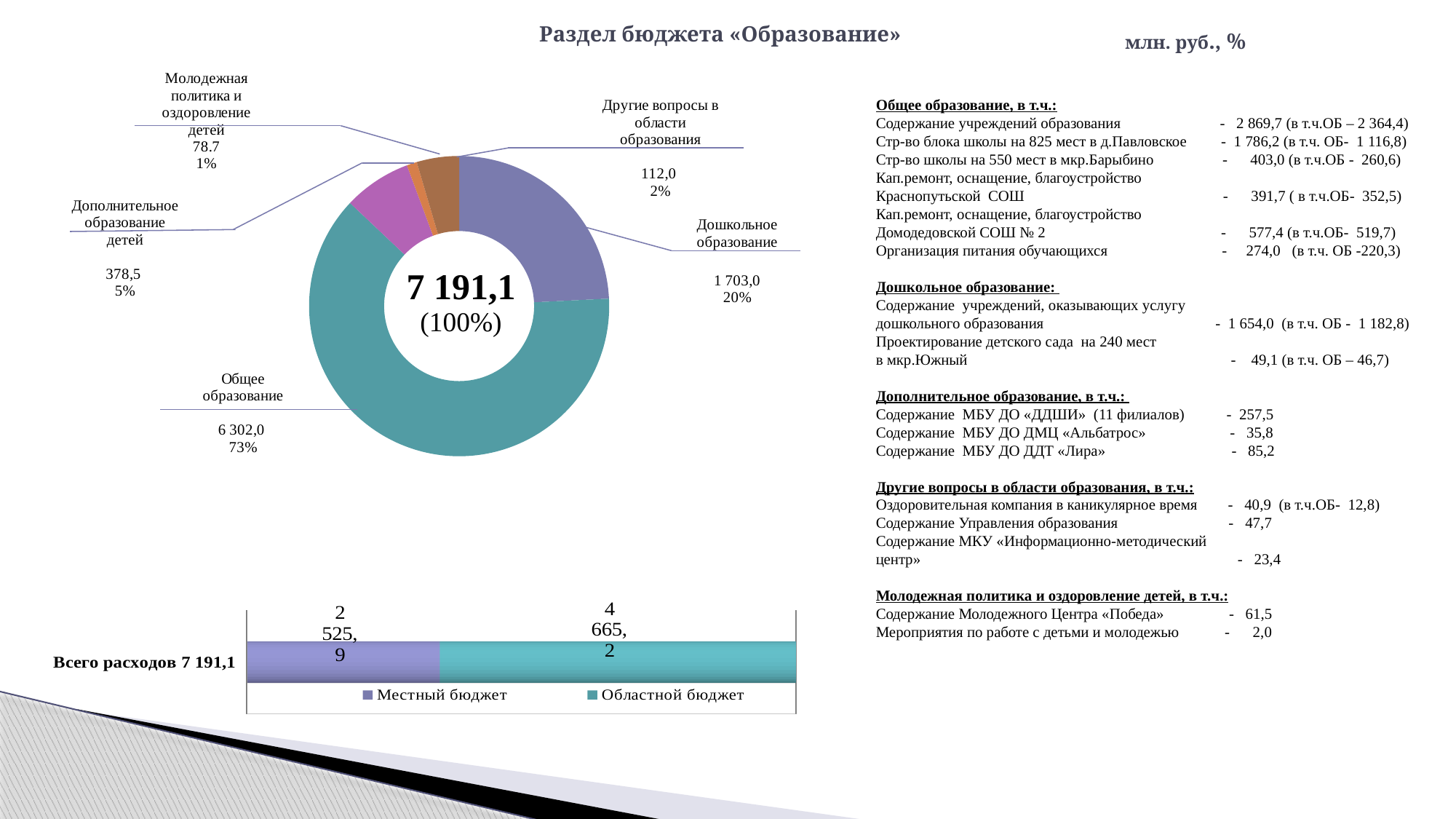
On the doughnut chart, what share does Дополнительное образование детей have? 5% On the bottom bar chart, how many series does the legend list? 2 On the doughnut chart, which category has the largest share? Общее образование On the bottom bar chart, what is the value for Областной бюджет? 4 665,2 On the doughnut chart, how many categories are shown? 5 On the doughnut chart, what total value is printed in the centre? 7 191,1 On the doughnut chart, what is the value for Дошкольное образование? 1 703,0 On the bottom bar chart, which is larger, Местный бюджет or Областной бюджет? Областной бюджет On the doughnut chart, what is the value for Общее образование? 6 302,0 What kind of chart is the chart at the bottom of the slide? Bar chart On the doughnut chart, which category has the smallest share? Молодежная политика и оздоровление детей On the doughnut chart, what is the difference between Общее образование and Дошкольное образование? 4 599,0